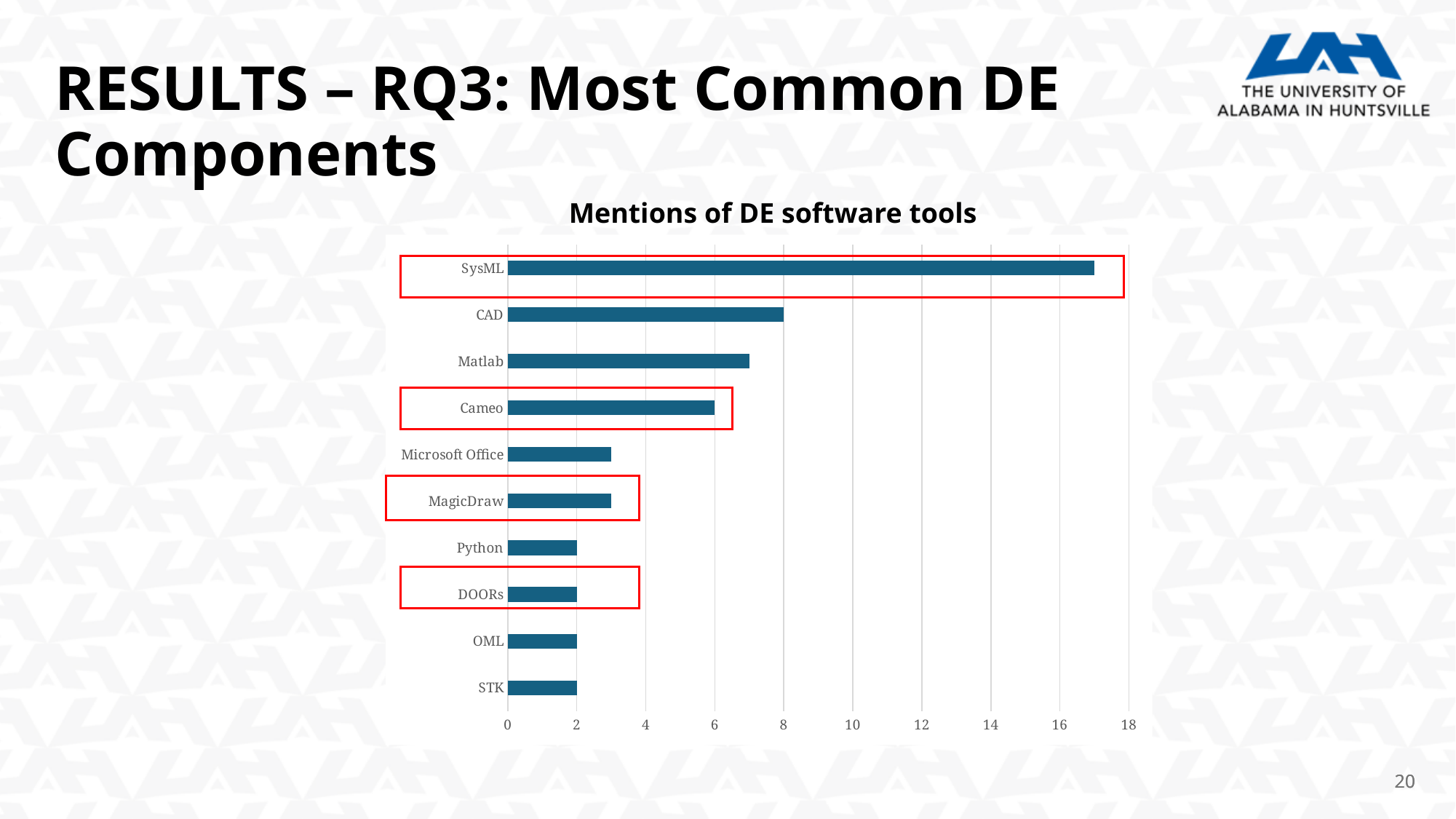
Is the value for SysML greater or less than 16? greater How many mentions does CAD have? 8 Which software tool has the most mentions? SysML Is the value for Microsoft Office greater or less than 4? less How many software tools are listed in the chart? 10 How many mentions does Python have? 2 Which has more mentions, CAD or Matlab? CAD What is the difference in mentions between CAD and Cameo? 2 How many mentions does Cameo have? 6 What is the title of the chart? Mentions of DE software tools What kind of chart is shown on the slide? bar chart Is the value for Matlab greater or less than 8? less